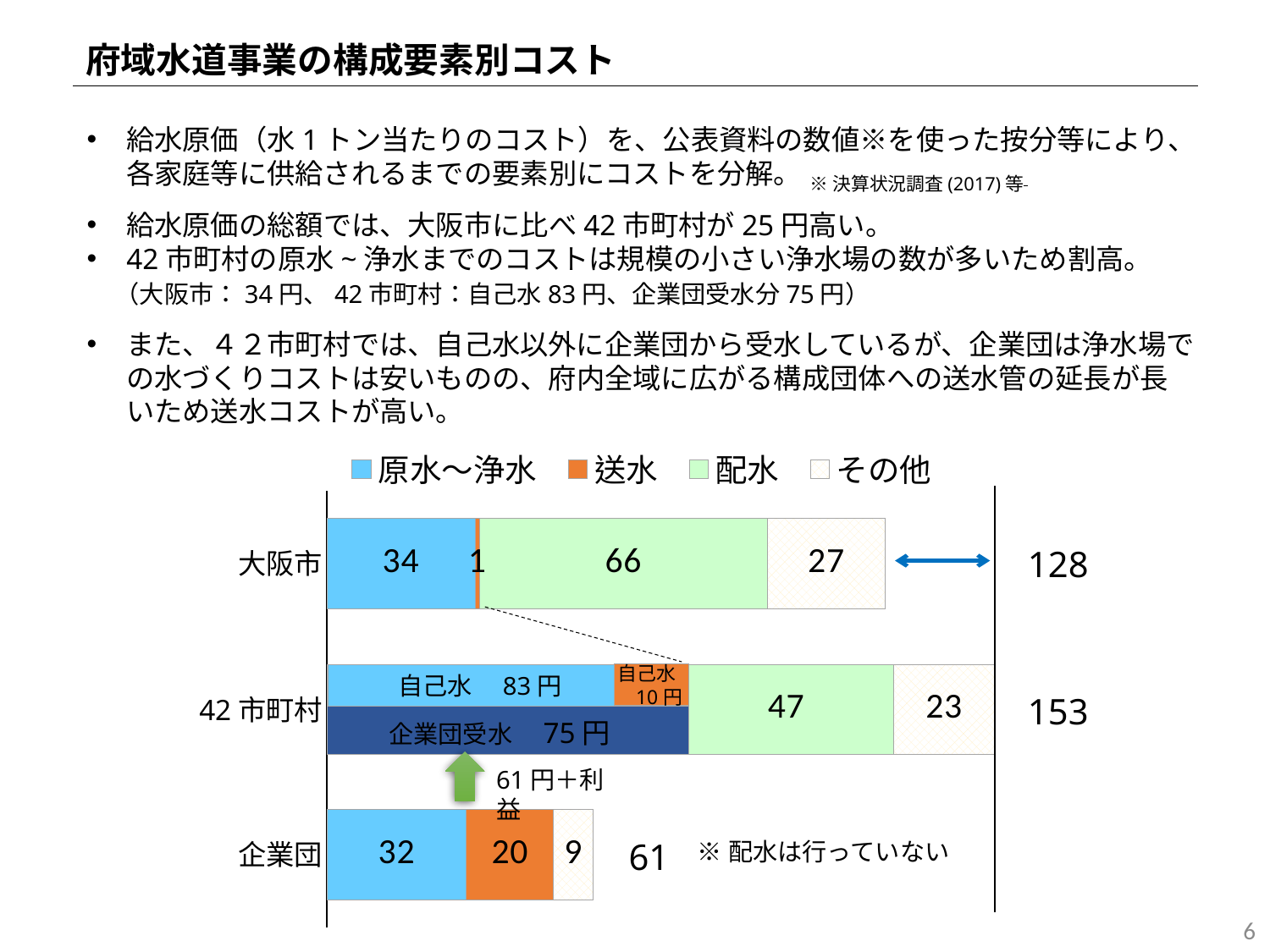
What is the total shown for 42市町村? 153 What is the その他 value for 42市町村? 23 Which category has the highest total? 42市町村 What is the total shown for 企業団? 61 What is the difference between the totals of 42市町村 and 大阪市? 25 How many series does the chart legend list? 4 What is the 原水～浄水 value for 大阪市? 34 How many categories (rows) are plotted in the chart? 3 What is the 送水 value for 企業団? 20 Which is larger, the 配水 value for 大阪市 or the 配水 value for 42市町村? 大阪市 What kind of chart is shown on the slide? stacked bar chart What is the 配水 value for 大阪市? 66